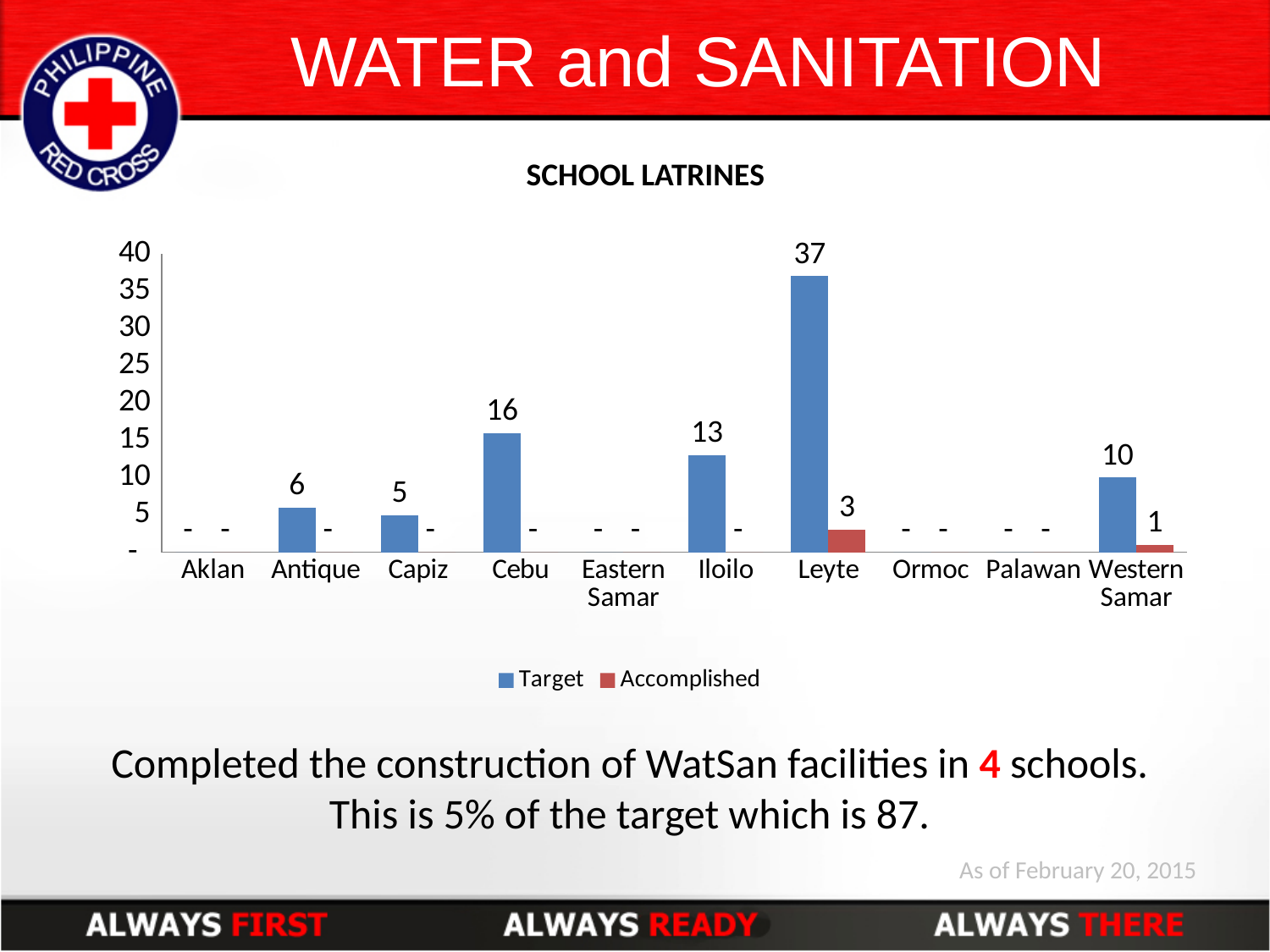
What is the difference between the Target and Accomplished values for Leyte? 34 What is the Target value for Cebu? 16 What is the Accomplished value for Western Samar? 1 What is the difference between the Target values for Cebu and Iloilo? 3 Which category has the highest Target value? Leyte How many series does the chart legend list? 2 What is the Accomplished value for Leyte? 3 What is the Target value for Leyte? 37 Which has a larger Target value, Antique or Capiz? Antique How many categories are shown on the x axis of the chart? 10 What type of chart is shown on the slide? bar chart What is the title of the chart? SCHOOL LATRINES